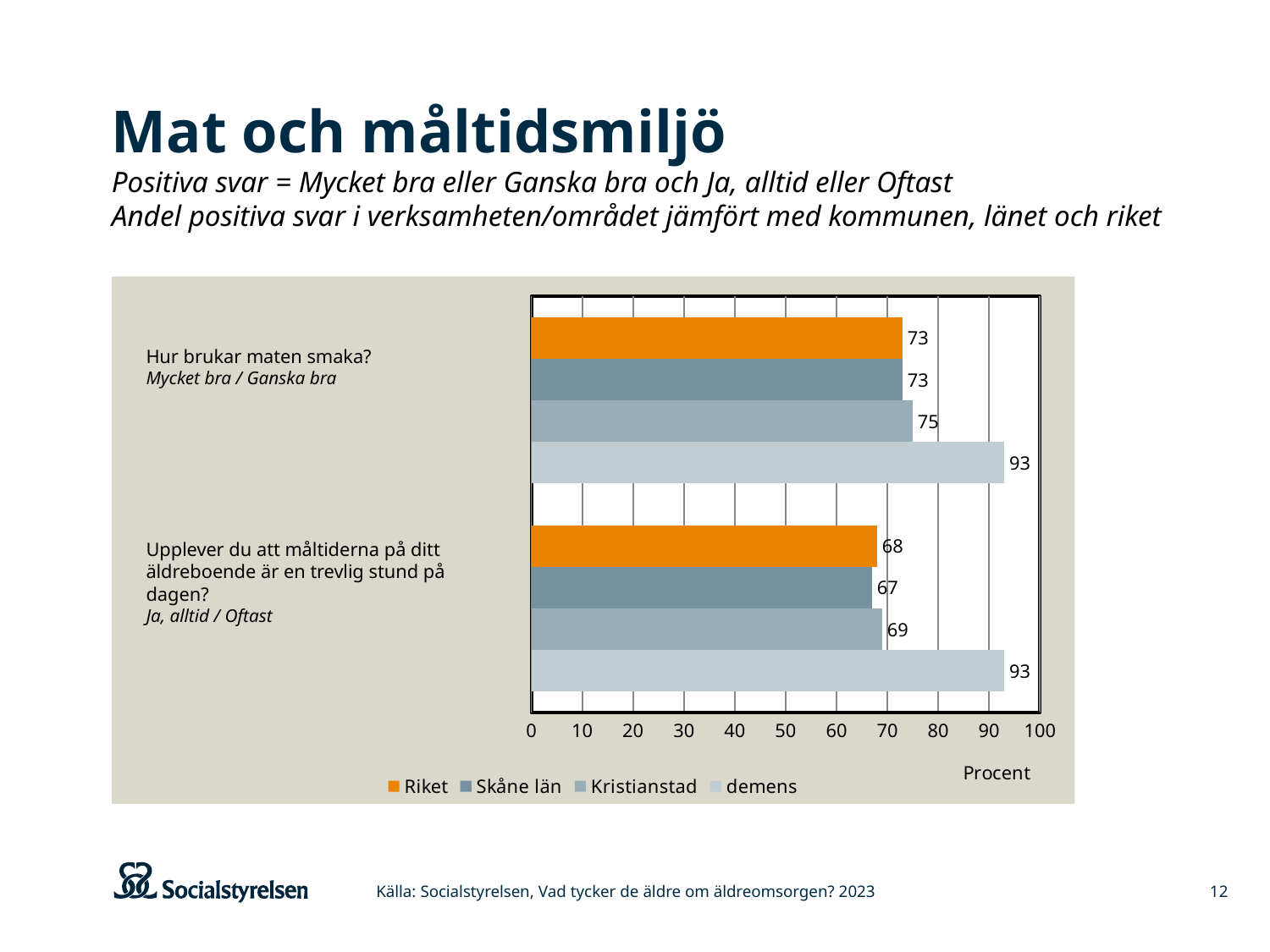
How many series does the legend list? 4 What kind of chart is shown on the slide? bar chart What is the value for Kristianstad on the question "Hur brukar maten smaka?"? 75 What is the difference between the demens value and the Riket value for "Upplever du att måltiderna på ditt äldreboende är en trevlig stund på dagen?"? 25 Which series has the lowest value for "Upplever du att måltiderna på ditt äldreboende är en trevlig stund på dagen?"? Skåne län What is the value for Riket on the question "Upplever du att måltiderna på ditt äldreboende är en trevlig stund på dagen?"? 68 What is the value for demens on the question "Hur brukar maten smaka?"? 93 What label is shown on the horizontal axis of the chart? Procent Which series has the highest value for "Hur brukar maten smaka?"? demens What is the value for Skåne län on the question "Upplever du att måltiderna på ditt äldreboende är en trevlig stund på dagen?"? 67 What is the difference between the demens value and the Kristianstad value for "Hur brukar maten smaka?"? 18 Is the Kristianstad value for "Hur brukar maten smaka?" greater or less than 70? greater